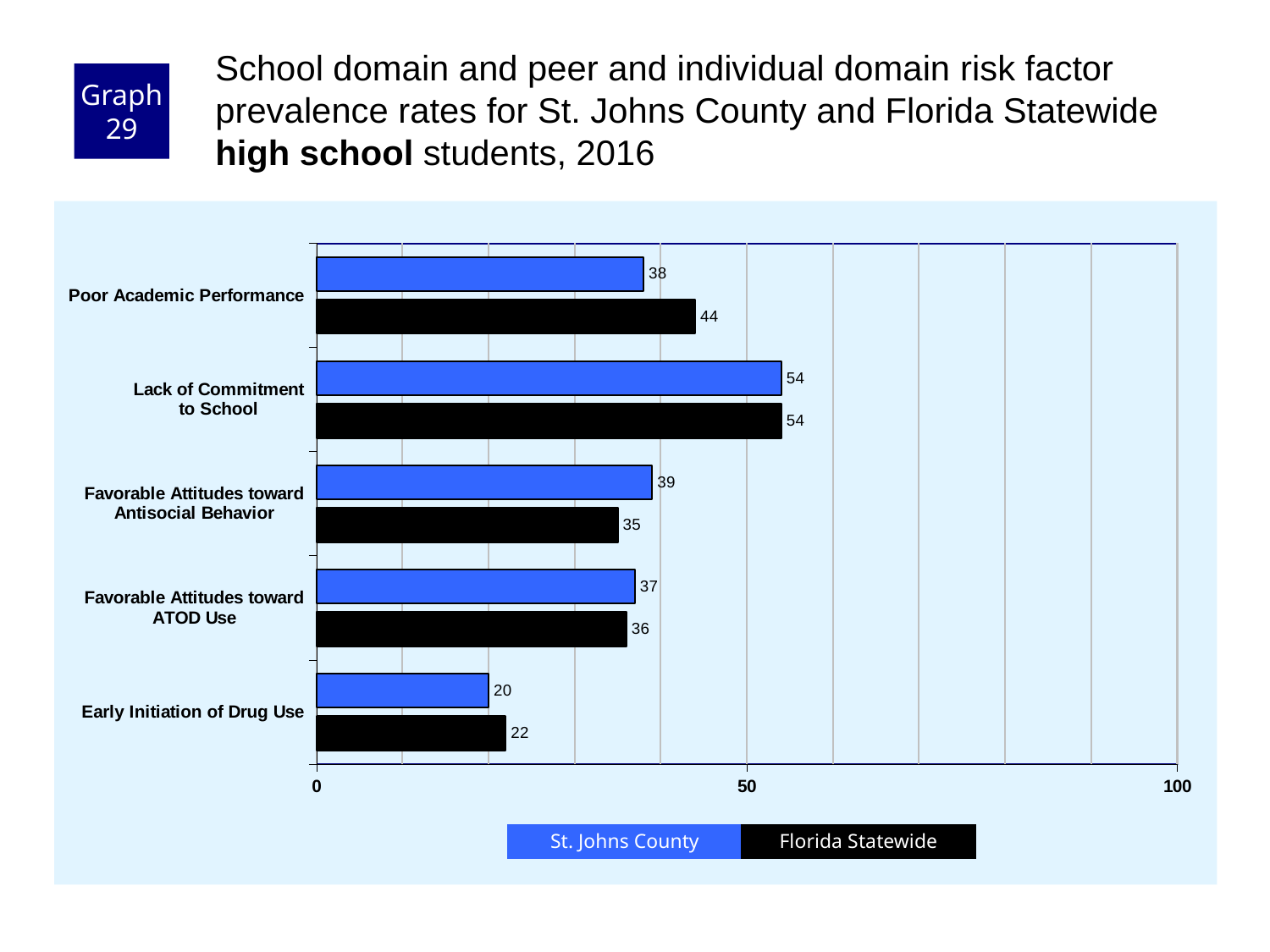
How many risk factor categories are shown on the chart? 5 What is the Florida Statewide value for Favorable Attitudes toward Antisocial Behavior? 35 Is the St. Johns County value for Lack of Commitment to School greater or less than 50? greater What is the St. Johns County value for Poor Academic Performance? 38 What kind of chart is shown on the slide? bar chart How many series does the legend list? 2 Which risk factor has the lowest Florida Statewide value? Early Initiation of Drug Use Which risk factor has the highest St. Johns County value? Lack of Commitment to School Which colour represents Florida Statewide in the chart? black What is the Florida Statewide value for Early Initiation of Drug Use? 22 For Favorable Attitudes toward Antisocial Behavior, which is larger: the St. Johns County value or the Florida Statewide value? St. Johns County What is the difference between the Florida Statewide and St. Johns County values for Poor Academic Performance? 6